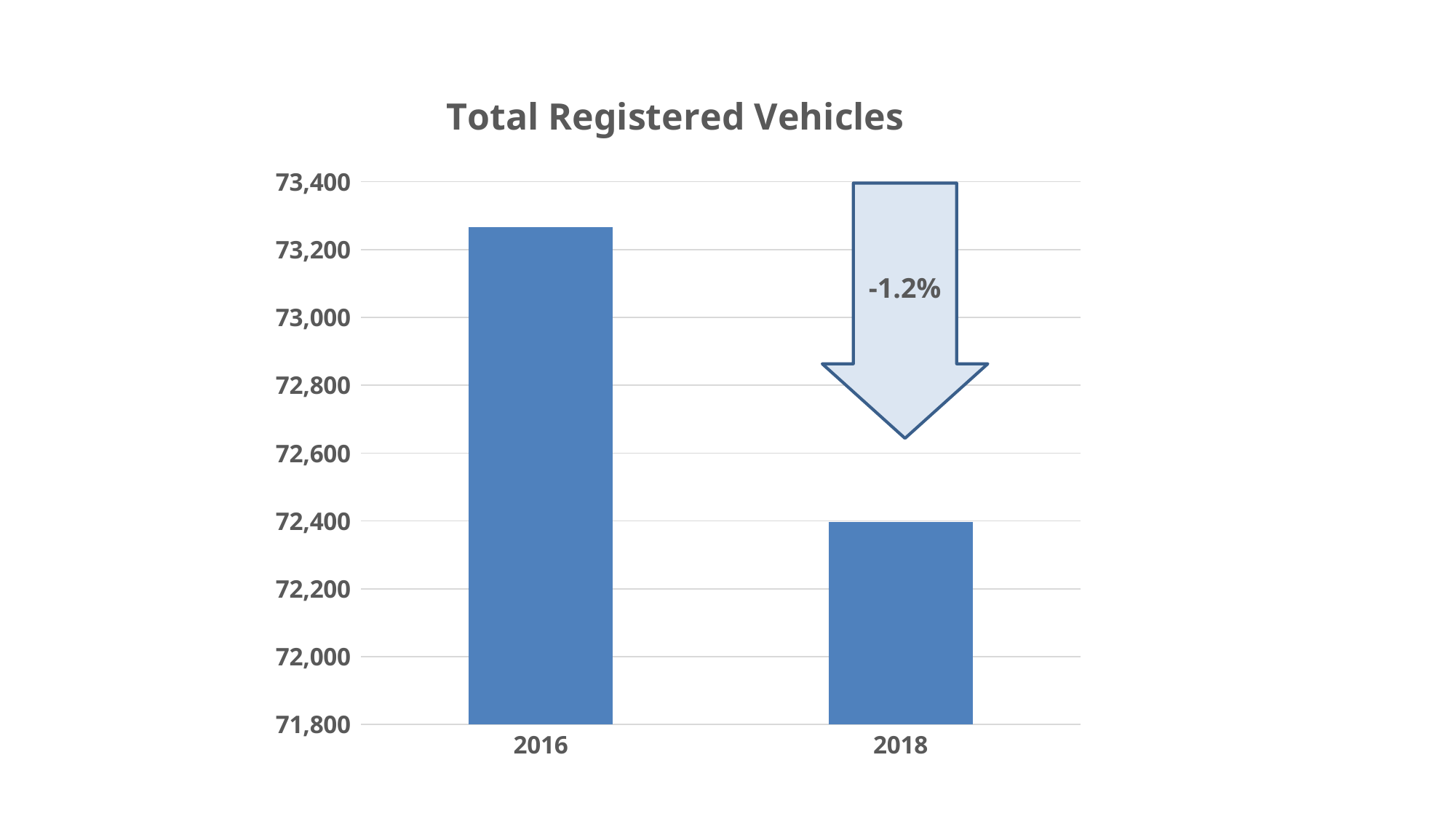
Which year has the lowest value for Total Registered Vehicles? 2018 Which year has the highest value for Total Registered Vehicles? 2016 What type of chart is shown on the slide? bar chart How many bars are plotted in the chart? 2 Which is larger, the value for 2016 or the value for 2018? 2016 What is the title of the chart? Total Registered Vehicles Is the value for 2018 greater or less than 72,600? less Do the values rise or fall from 2016 to 2018? fall Is the value for 2016 greater or less than 73,200? greater Is the value for 2016 greater or less than 73,400? less What percentage change is printed on the arrow annotation in the chart? -1.2%